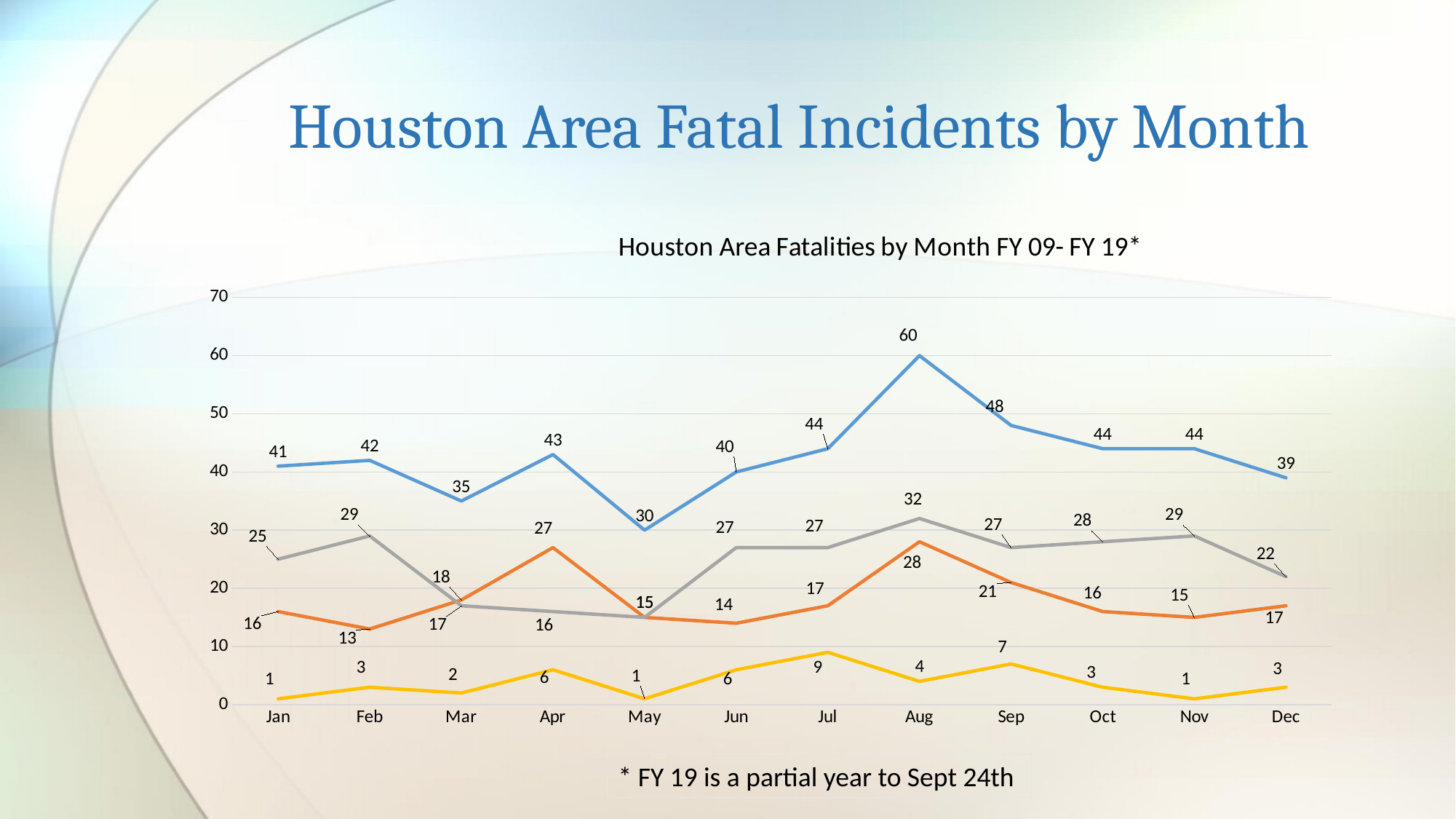
What is the title of the chart? Houston Area Fatalities by Month FY 09- FY 19* What is the value of the gray line in Aug? 32 In which month does the blue line reach its highest value? Aug In which month does the blue line reach its lowest value? May Is the blue line's value in Aug greater or less than 50? greater Which is larger for the gray line: the value in Feb or the value in Mar? Feb What type of chart is shown on the slide? line chart What is the difference between the blue line's value in Aug and its value in Sep? 12 How many months are shown on the x axis of the chart? 12 What is the value of the yellow line in Jul? 9 What is the value of the orange line in Apr? 27 What is the value of the blue line in Aug? 60